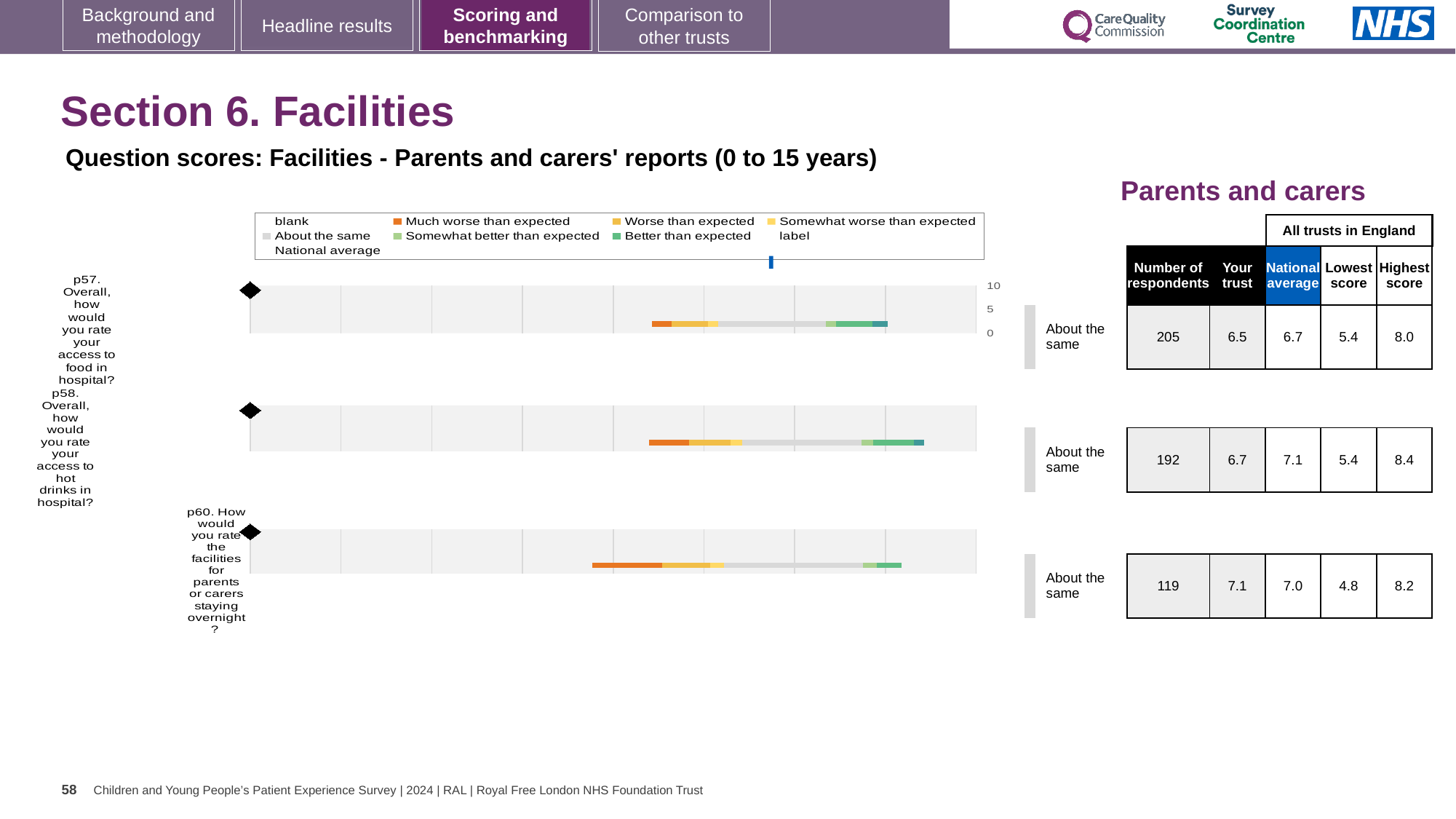
What benchmark category is shown for p57 (access to food in hospital)? About the same What is the national average score for p58 (access to hot drinks in hospital)? 7.1 What is the difference between the highest score and the lowest score for p58? 3.0 How many respondents answered p60 (facilities for parents or carers staying overnight)? 119 What kind of chart is used to show the question scores for Facilities? bar chart Which question has the highest 'Your trust' score? p60. How would you rate the facilities for parents or carers staying overnight? What is the highest score across all trusts in England for p58? 8.4 For p57, which is larger: the 'Your trust' score or the national average? National average What colour in the legend represents 'Much worse than expected'? Orange How many questions (bars) are plotted in the Facilities chart? 3 Which question has the lowest number of respondents? p60. How would you rate the facilities for parents or carers staying overnight? What is the 'Your trust' score for p57 (access to food in hospital)? 6.5